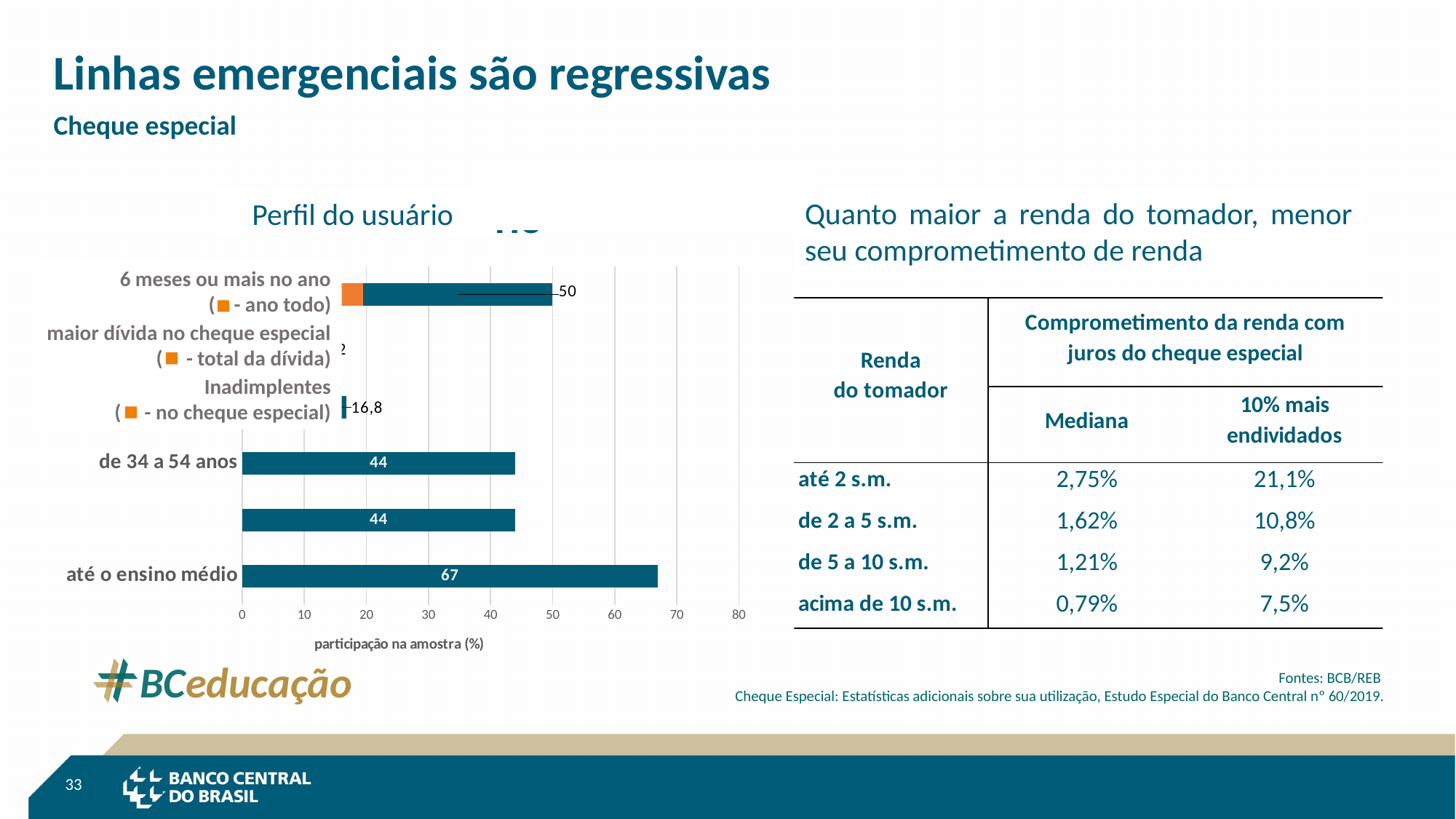
In the 'Perfil do usuário' chart, what is the value for 'até o ensino médio'? 67 In the 'Perfil do usuário' chart, what is the value for 'de 34 a 54 anos'? 44 In the 'Perfil do usuário' chart, is the value for 'até o ensino médio' greater or less than 60? greater In the 'Perfil do usuário' chart, what is the value for '6 meses ou mais no ano'? 50 In the 'Perfil do usuário' chart, is the value for 'Inadimplentes' greater or less than 20? less In the 'Perfil do usuário' chart, what is the difference between the values for '6 meses ou mais no ano' and 'Inadimplentes'? 33,2 What kind of chart is 'Perfil do usuário'? bar chart In the 'Perfil do usuário' chart, what is the value for 'Inadimplentes'? 16,8 In the 'Perfil do usuário' chart, which category has the highest value? até o ensino médio In the 'Perfil do usuário' chart, which is larger: the value for '6 meses ou mais no ano' or for 'de 34 a 54 anos'? 6 meses ou mais no ano In the 'Perfil do usuário' chart, what is the difference between the values for 'até o ensino médio' and 'de 34 a 54 anos'? 23 What is the x-axis label of the 'Perfil do usuário' chart? participação na amostra (%)